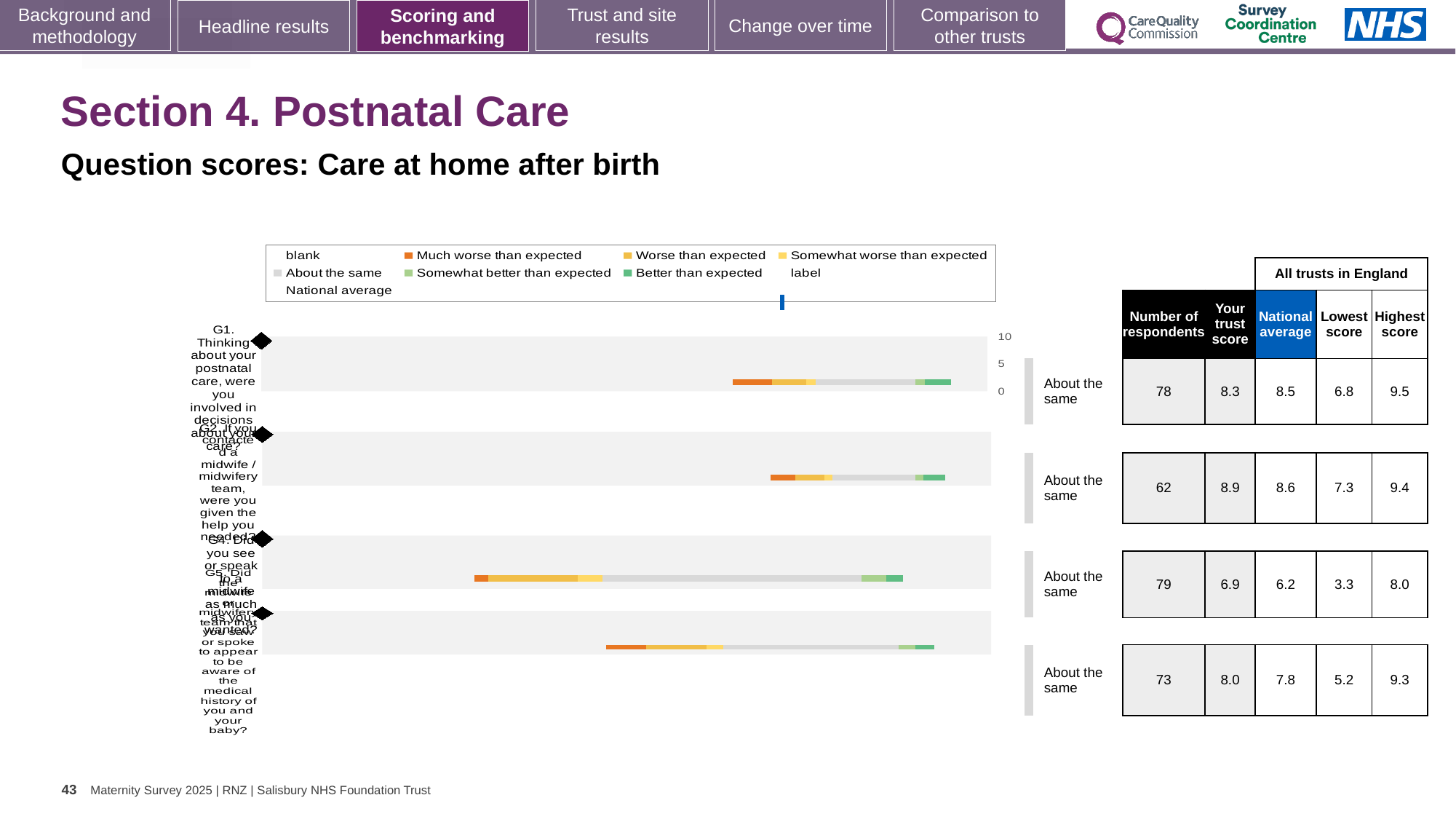
What is the maximum value shown on the chart's score axis? 10 What is the Highest score for the fourth question row (G5)? 9.3 For the third question row (G4), which is larger: the trust score or the national average? the trust score (6.9) What benchmark label is shown for each of the four questions? About the same How many questions (bars) are plotted in the chart? 4 What kind of chart is shown on the slide? bar chart What is the National average for the first question row (G1)? 8.5 Which question row has the highest 'Your trust score'? G2 (8.9) What is the 'Your trust score' for the first question row (G1)? 8.3 How many respondents are listed for the second question row (G2)? 62 What is the difference between the trust score and the national average for the second question row (G2)? 0.3 Which question row has the lowest 'Lowest score' across all trusts in England? G4 (3.3)